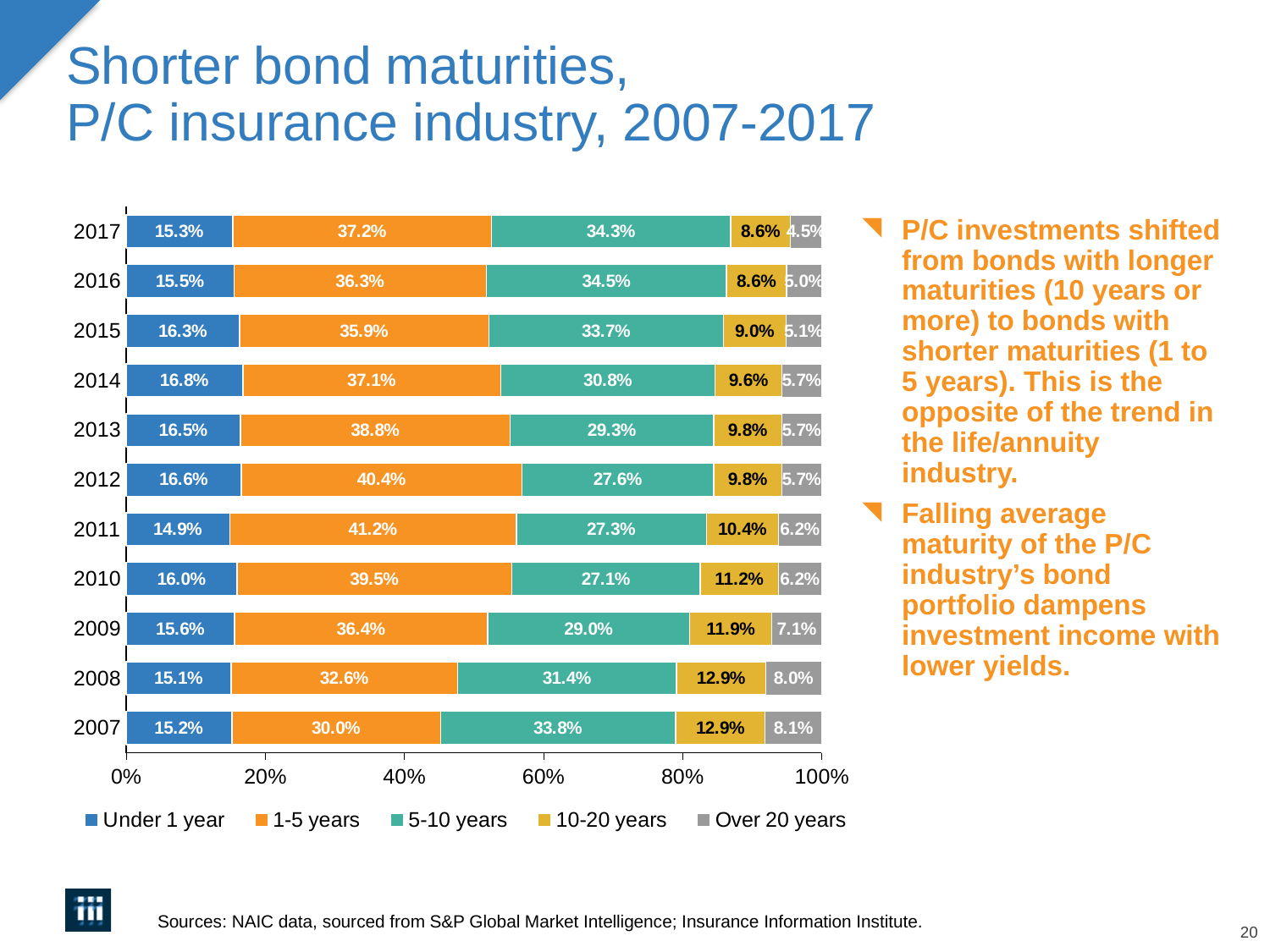
Did the 'Over 20 years' share rise or fall from 2007 to 2017? Fall In which year was the 'Over 20 years' share the lowest? 2017 Which maturity category is shown in orange in the legend? 1-5 years What was the 'Under 1 year' share in 2011? 14.9% What type of chart is shown on the slide? Stacked bar chart How many maturity categories does the legend list? 5 What share of P/C industry bonds had maturities of 1-5 years in 2017? 37.2% What was the 'Over 20 years' share in 2007? 8.1% In which year was the '1-5 years' share the highest? 2011 How many years are shown on the chart? 11 By how many percentage points did the '10-20 years' share fall from 2007 to 2017? 4.3 percentage points Which was larger in 2012: the '1-5 years' share or the '5-10 years' share? 1-5 years